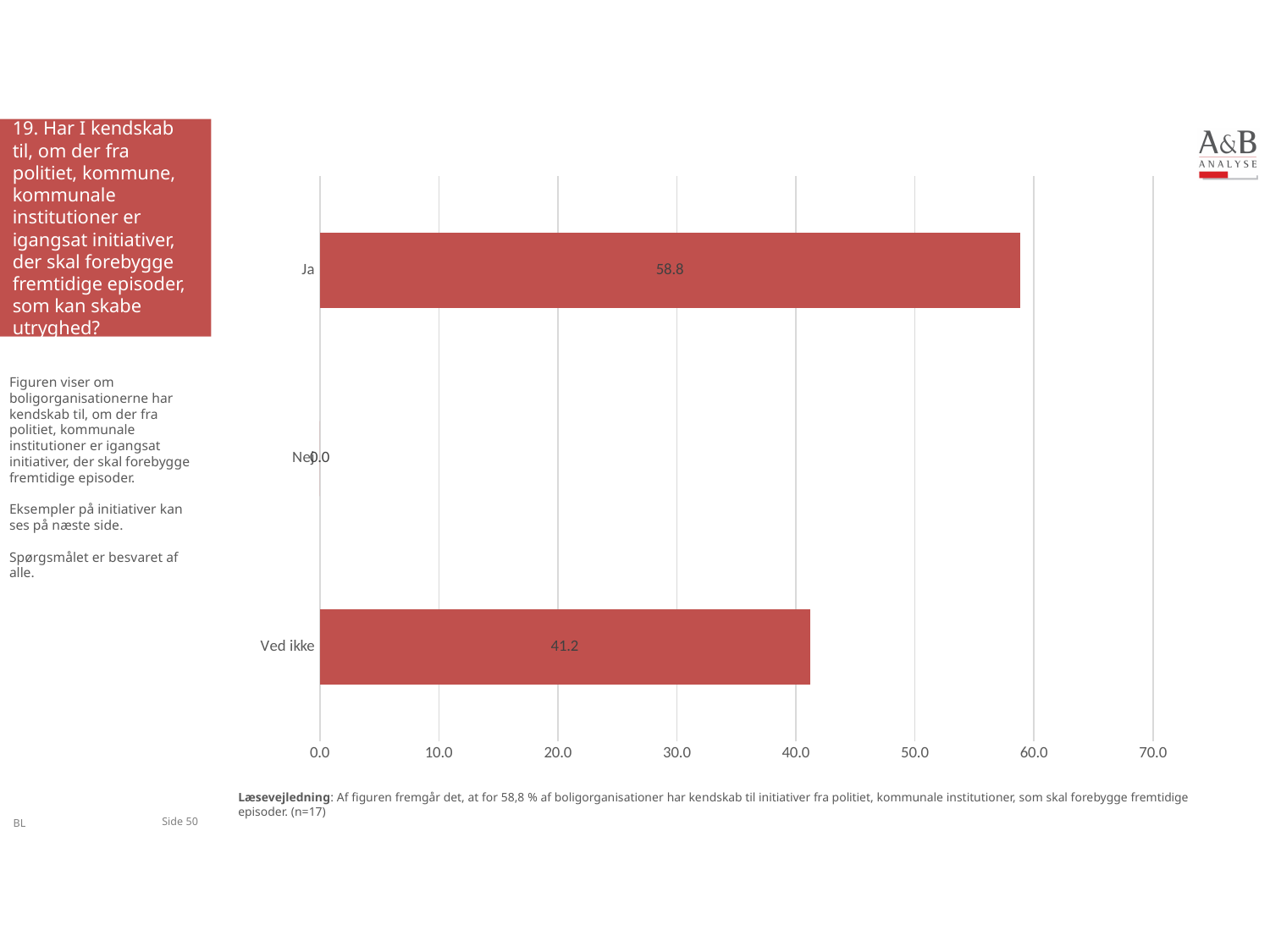
What is the value for "Ja"? 58.8 What kind of chart is shown on the slide? bar chart What is the highest value shown on the x axis? 70.0 How many categories are shown in the chart? 3 Is the value for "Ved ikke" greater or less than 50.0? less What is the difference between the values for "Ja" and "Ved ikke"? 17.6 Is the value for "Ja" greater or less than 50.0? greater What is the value for "Ved ikke"? 41.2 Which category has the highest value? Ja Which category has the lowest value? Nej What is the value for "Nej"? 0.0 Which is larger, the value for "Ja" or the value for "Ved ikke"? Ja